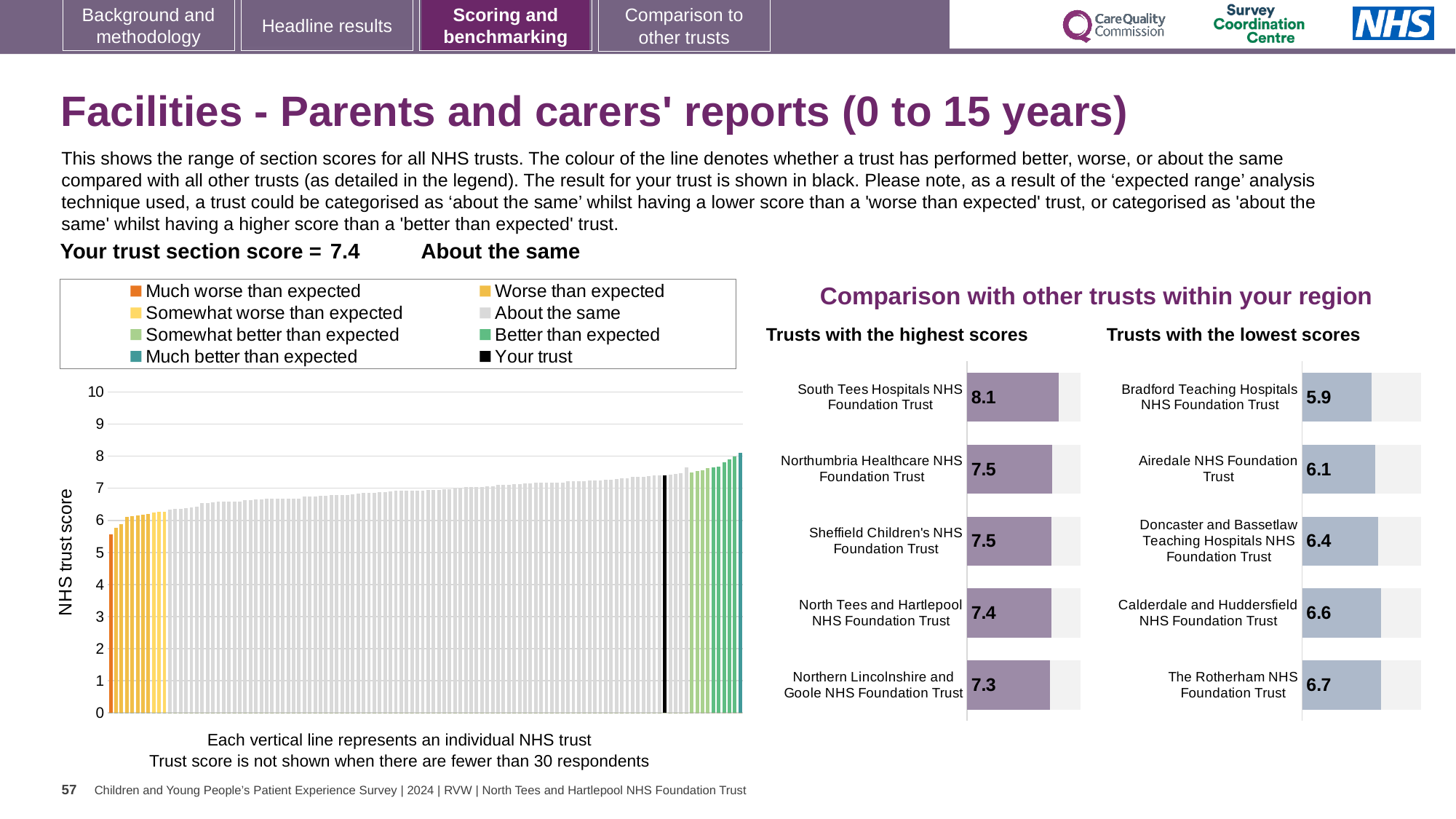
What kind of chart is the main 'NHS trust score' chart on the left? Bar chart In the 'Trusts with the lowest scores' chart, which has the larger score: Airedale NHS Foundation Trust or Doncaster and Bassetlaw Teaching Hospitals NHS Foundation Trust? Doncaster and Bassetlaw Teaching Hospitals NHS Foundation Trust In the 'Trusts with the highest scores' chart, which trust has the highest score? South Tees Hospitals NHS Foundation Trust In the 'Trusts with the highest scores' chart, what is the score for South Tees Hospitals NHS Foundation Trust? 8.1 In the 'Trusts with the highest scores' chart, what is the difference between the scores of South Tees Hospitals NHS Foundation Trust and Northern Lincolnshire and Goole NHS Foundation Trust? 0.8 In the 'Trusts with the lowest scores' chart, what is the difference between the scores of The Rotherham NHS Foundation Trust and Bradford Teaching Hospitals NHS Foundation Trust? 0.8 In the 'Trusts with the lowest scores' chart, which trust has the lowest score? Bradford Teaching Hospitals NHS Foundation Trust In the 'Trusts with the lowest scores' chart, what is the score for Bradford Teaching Hospitals NHS Foundation Trust? 5.9 How many entries does the legend of the main 'NHS trust score' chart list? 8 How many trusts are shown in the 'Trusts with the lowest scores' chart? 5 In the 'Trusts with the highest scores' chart, what is the score for Northern Lincolnshire and Goole NHS Foundation Trust? 7.3 In the main 'NHS trust score' chart, do the values rise or fall from left to right? Rise